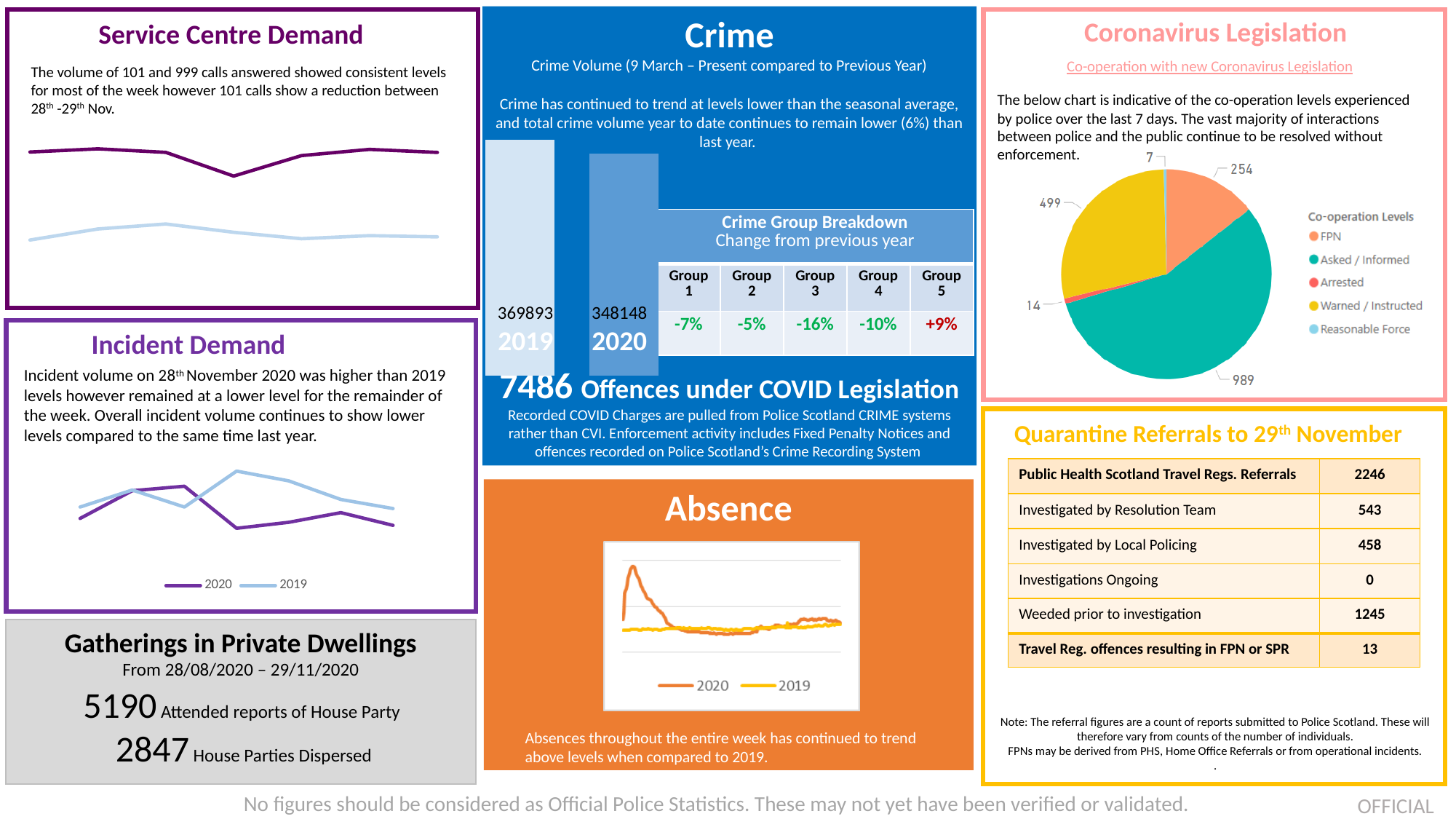
On the Crime bar chart, what is the crime volume shown for 2019? 369893 How many series does the legend of the Incident Demand line chart list? 2 On the Coronavirus Legislation pie chart, what is the difference between the Warned / Instructed value and the FPN value? 245 On the Coronavirus Legislation pie chart, which co-operation level has the smallest slice? Reasonable Force On the Coronavirus Legislation pie chart, which is larger, FPN or Warned / Instructed? Warned / Instructed On the Coronavirus Legislation pie chart, what is the value for Asked / Informed? 989 On the Crime bar chart, what is the crime volume shown for 2020? 348148 On the Crime bar chart, which year has the larger crime volume, 2019 or 2020? 2019 How many co-operation levels does the legend of the Coronavirus Legislation pie chart list? 5 On the Crime bar chart, what is the difference between the 2019 and 2020 crime volumes? 21745 On the Coronavirus Legislation pie chart, which co-operation level has the largest slice? Asked / Informed What kind of chart is used in the Crime panel to show the 2019 and 2020 volumes? bar chart